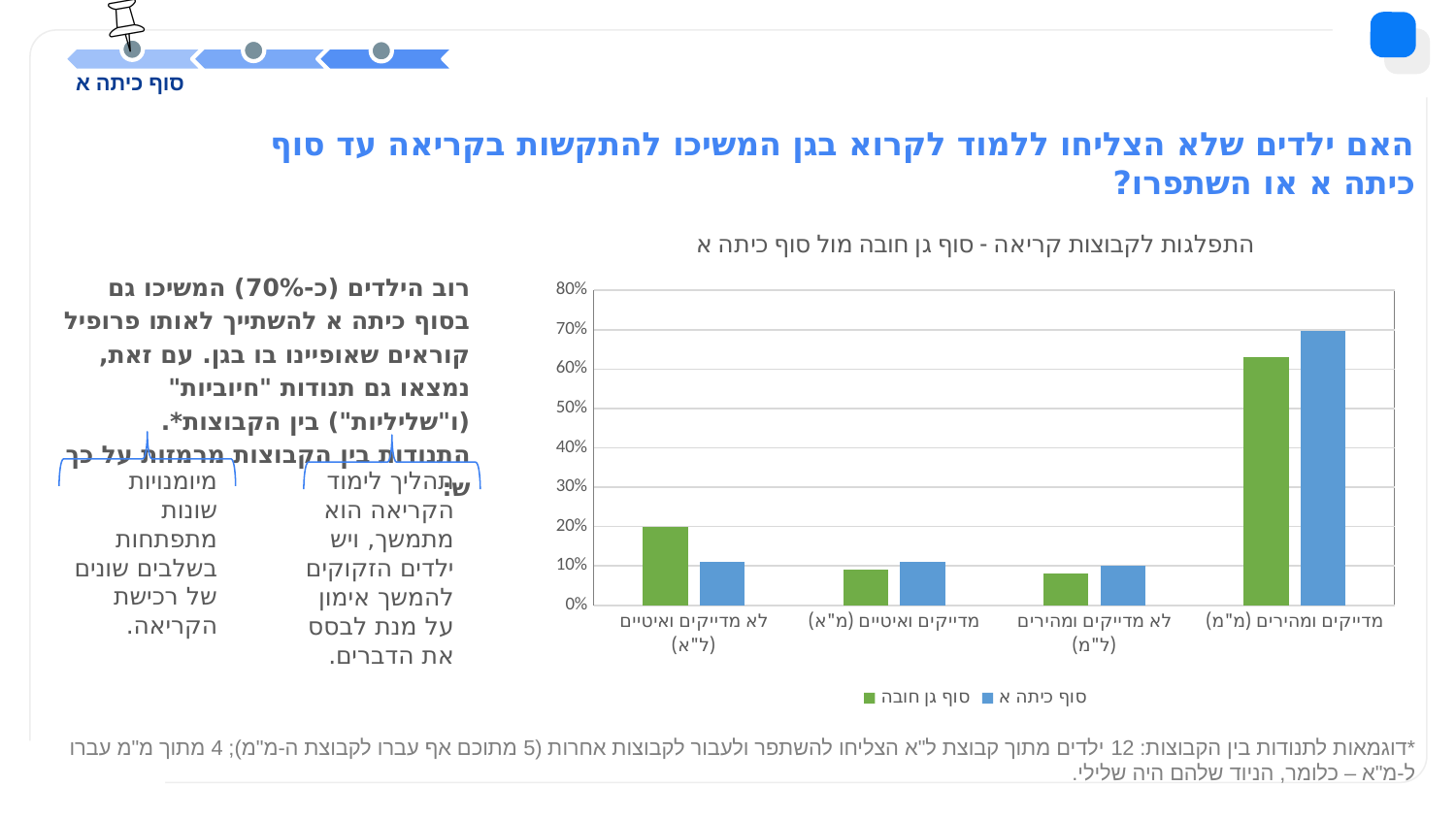
In the category מדייקים ומהירים (מ"מ), which series has the larger value, סוף גן חובה or סוף כיתה א? סוף כיתה א Is the value for סוף גן חובה in the category לא מדייקים ואיטיים (ל"א) greater or less than 10%? greater Which category has the highest value for the series סוף כיתה א? מדייקים ומהירים (מ"מ) Is the value for סוף כיתה א in the category לא מדייקים ואיטיים (ל"א) greater or less than 20%? less What kind of chart is shown on the slide? bar chart Which category has the highest value for the series סוף גן חובה? מדייקים ומהירים (מ"מ) How many categories are shown on the x axis of the chart? 4 In the category לא מדייקים ואיטיים (ל"א), which series has the larger value, סוף גן חובה or סוף כיתה א? סוף גן חובה How many series does the chart's legend list? 2 Which series is shown in green in the chart? סוף גן חובה Is the value for סוף כיתה א in the category מדייקים ומהירים (מ"מ) greater or less than 60%? greater What is the title of the chart? התפלגות לקבוצות קריאה - סוף גן חובה מול סוף כיתה א